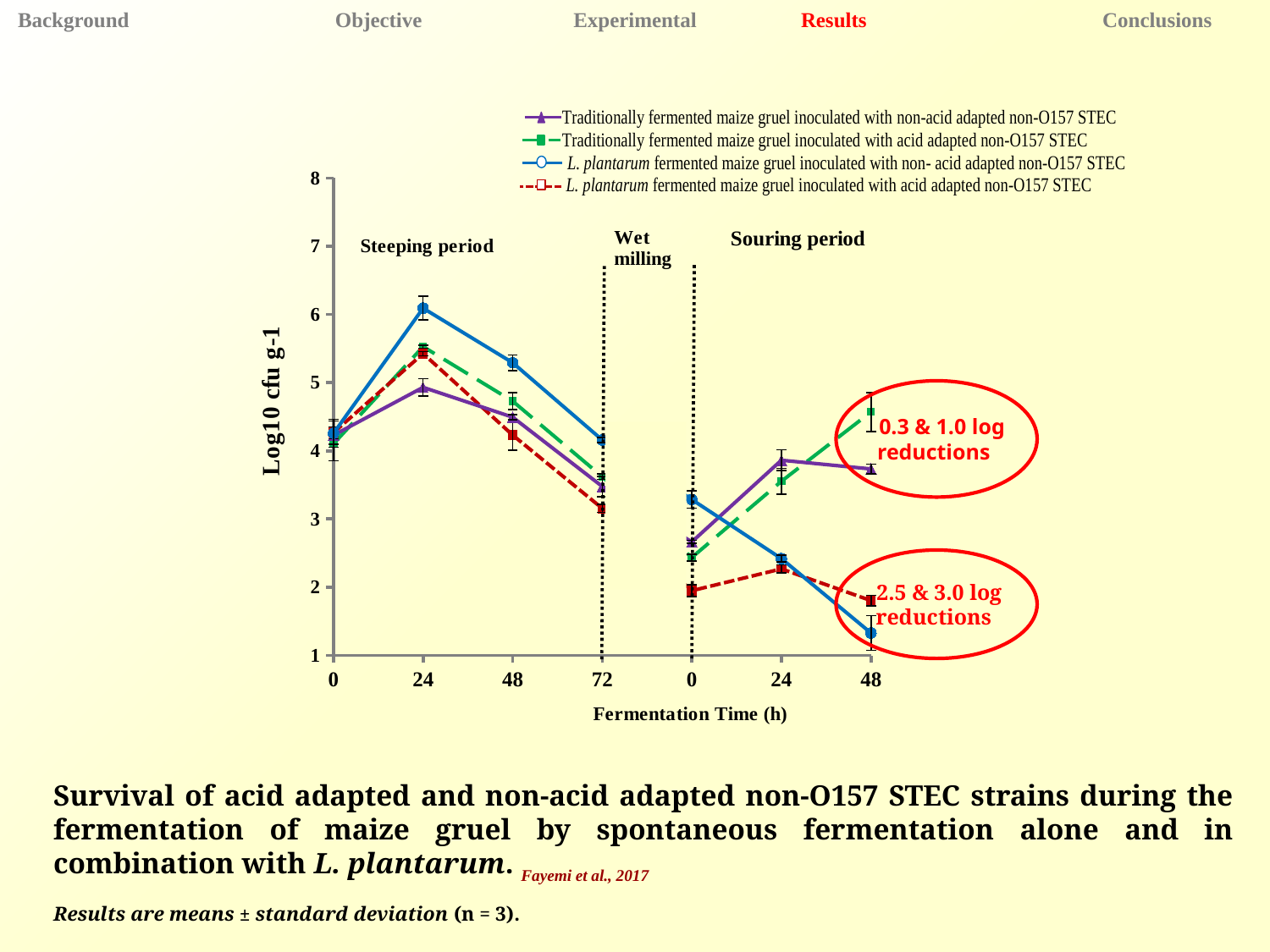
Which series has the highest value at 48 h of the souring period? Traditionally fermented maize gruel inoculated with acid adapted non-O157 STEC Which series has the lowest value at 48 h of the souring period? L. plantarum fermented maize gruel inoculated with non- acid adapted non-O157 STEC How many fermentation time points are marked along the x axis? 7 How many series does the legend list? 4 At 24 h of the souring period, which is larger: the value for Traditionally fermented maize gruel inoculated with non-acid adapted non-O157 STEC or the value for L. plantarum fermented maize gruel inoculated with acid adapted non-O157 STEC? Traditionally fermented maize gruel inoculated with non-acid adapted non-O157 STEC During the souring period, does the value for L. plantarum fermented maize gruel inoculated with non- acid adapted non-O157 STEC rise or fall from 0 h to 48 h? fall Is the value for L. plantarum fermented maize gruel inoculated with non- acid adapted non-O157 STEC at 24 h of the steeping period greater or less than 5? greater Which series has the highest value at 24 h of the steeping period? L. plantarum fermented maize gruel inoculated with non- acid adapted non-O157 STEC Is the value for L. plantarum fermented maize gruel inoculated with non- acid adapted non-O157 STEC at 48 h of the souring period greater or less than 2? less What is the label of the y axis? Log10 cfu g-1 What kind of chart is shown on the slide? line chart Is the value for Traditionally fermented maize gruel inoculated with acid adapted non-O157 STEC at 48 h of the souring period greater or less than 4? greater